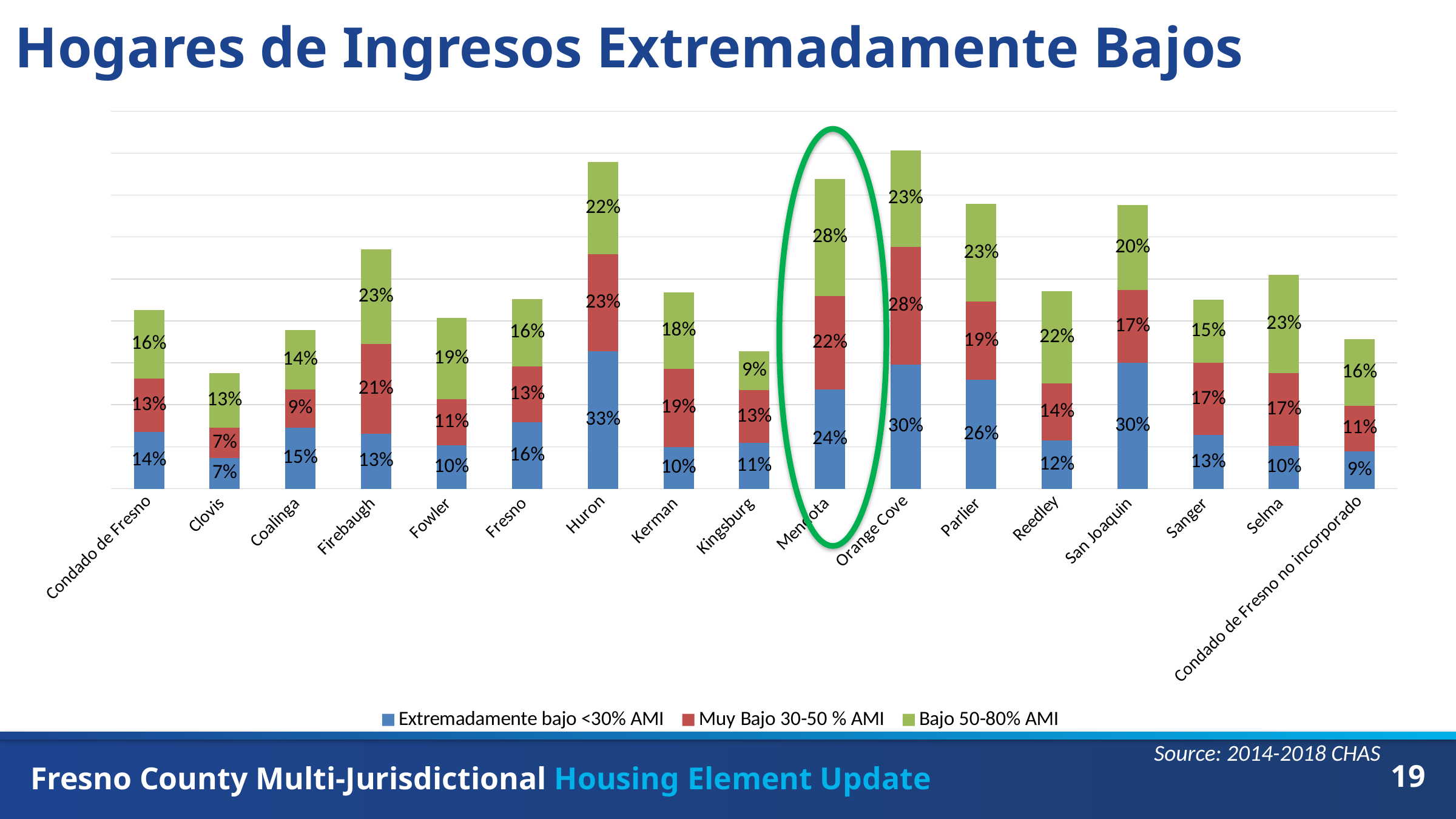
Which category has the highest value in the Extremadamente bajo <30% AMI series? Huron What is the total of the stacked bar for Mendota? 74% How many categories are shown on the x axis? 17 Which category has the lowest value in the Bajo 50-80% AMI series? Kingsburg What is the value for Huron in the Extremadamente bajo <30% AMI series? 33% What kind of chart is shown on the slide? Stacked bar chart Which is larger, the Muy Bajo 30-50 % AMI value for Firebaugh or for Fowler? Firebaugh What is the difference between the Extremadamente bajo <30% AMI values for Huron and Clovis? 26% What is the value for Mendota in the Bajo 50-80% AMI series? 28% What is the value for Orange Cove in the Muy Bajo 30-50 % AMI series? 28% How many series does the legend list? 3 What is the total of the stacked bar for Clovis? 27%